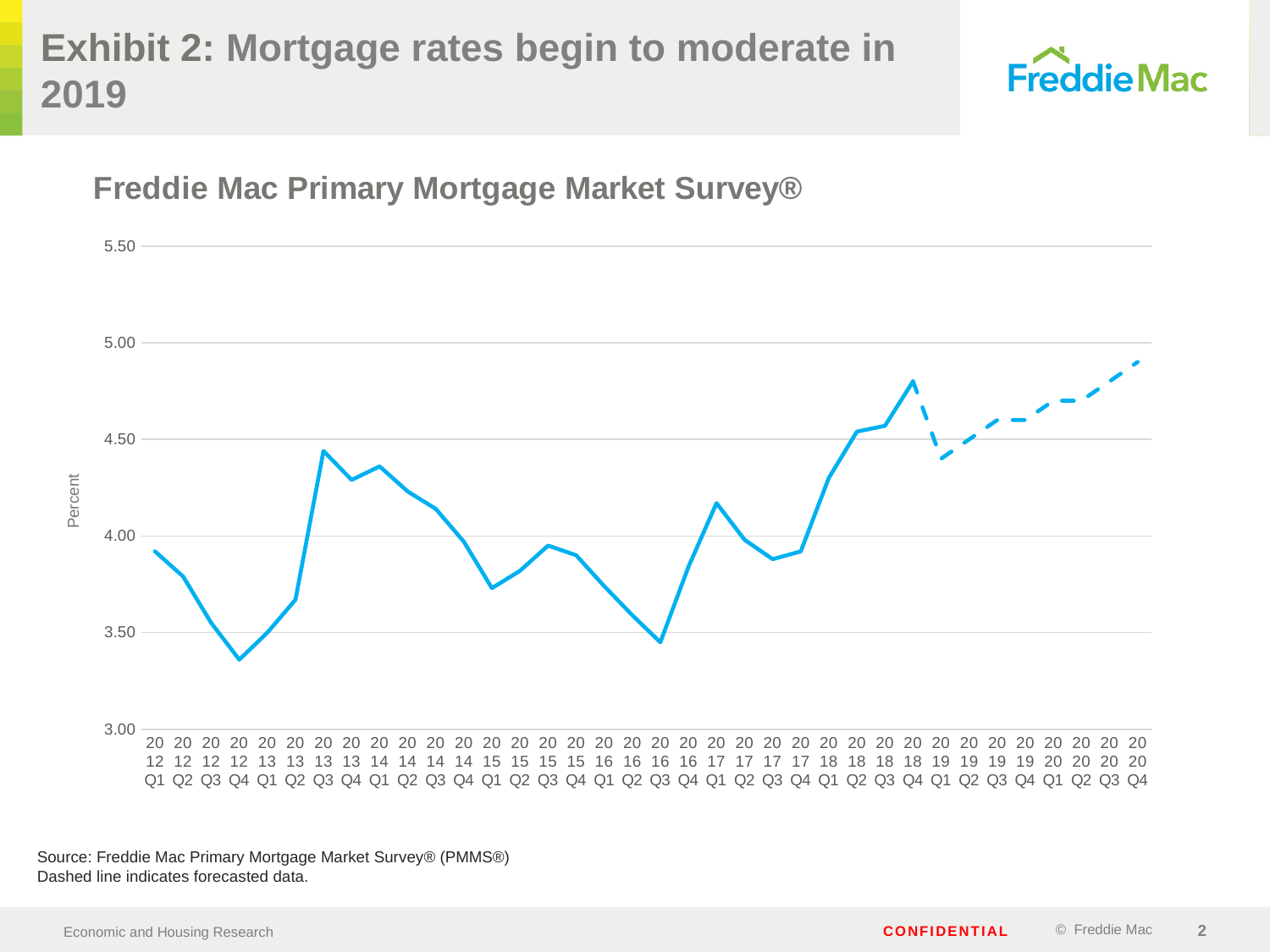
What kind of chart is shown on the slide? line chart Which is larger, the value for 2018 Q4 or the value for 2013 Q3? 2018 Q4 Is the value for 2018 Q4 greater or less than 4.50? greater According to the note below the chart, what does the dashed line indicate? forecasted data Is the value for 2015 Q1 greater or less than 4.00? less Is the value for 2012 Q4 greater or less than 3.50? less How many quarterly data points are plotted on the x axis? 36 What is the label on the y axis? Percent Does the mortgage rate rise or fall between 2018 Q4 and 2019 Q1? fall